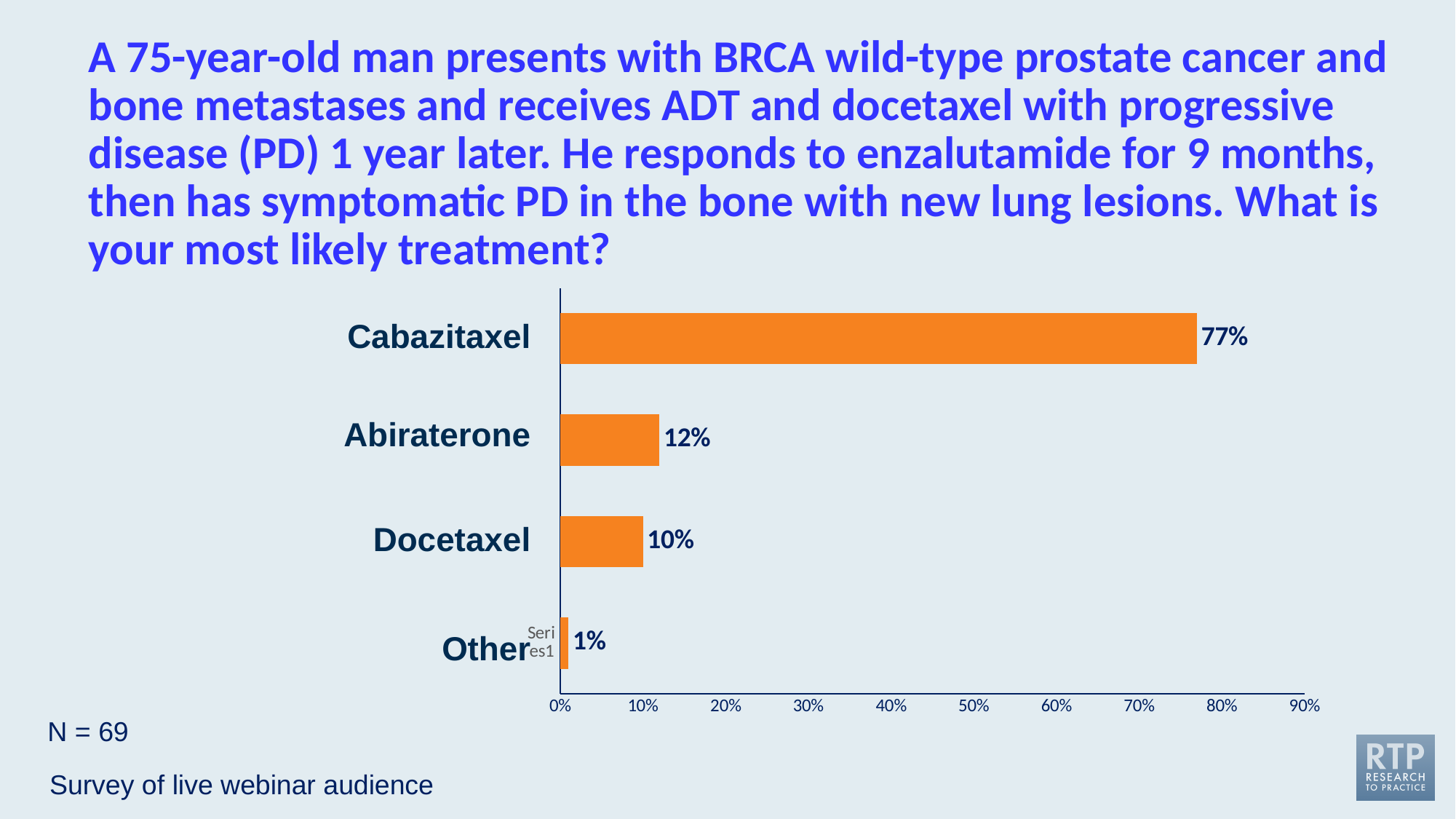
How many treatment options are shown in the chart? 4 What is the difference in percentage points between Abiraterone and Docetaxel? 2 What percentage of respondents chose Docetaxel? 10% Which treatment option received the highest share of responses? Cabazitaxel What percentage of respondents chose Other? 1% Is the value for Cabazitaxel greater or less than 70%? greater What percentage of respondents chose Cabazitaxel? 77% What is the difference in percentage points between Cabazitaxel and Abiraterone? 65 What kind of chart is shown on the slide? Bar chart Which received a larger share of responses, Cabazitaxel or Docetaxel? Cabazitaxel What percentage of respondents chose Abiraterone? 12% Which treatment option received the lowest share of responses? Other